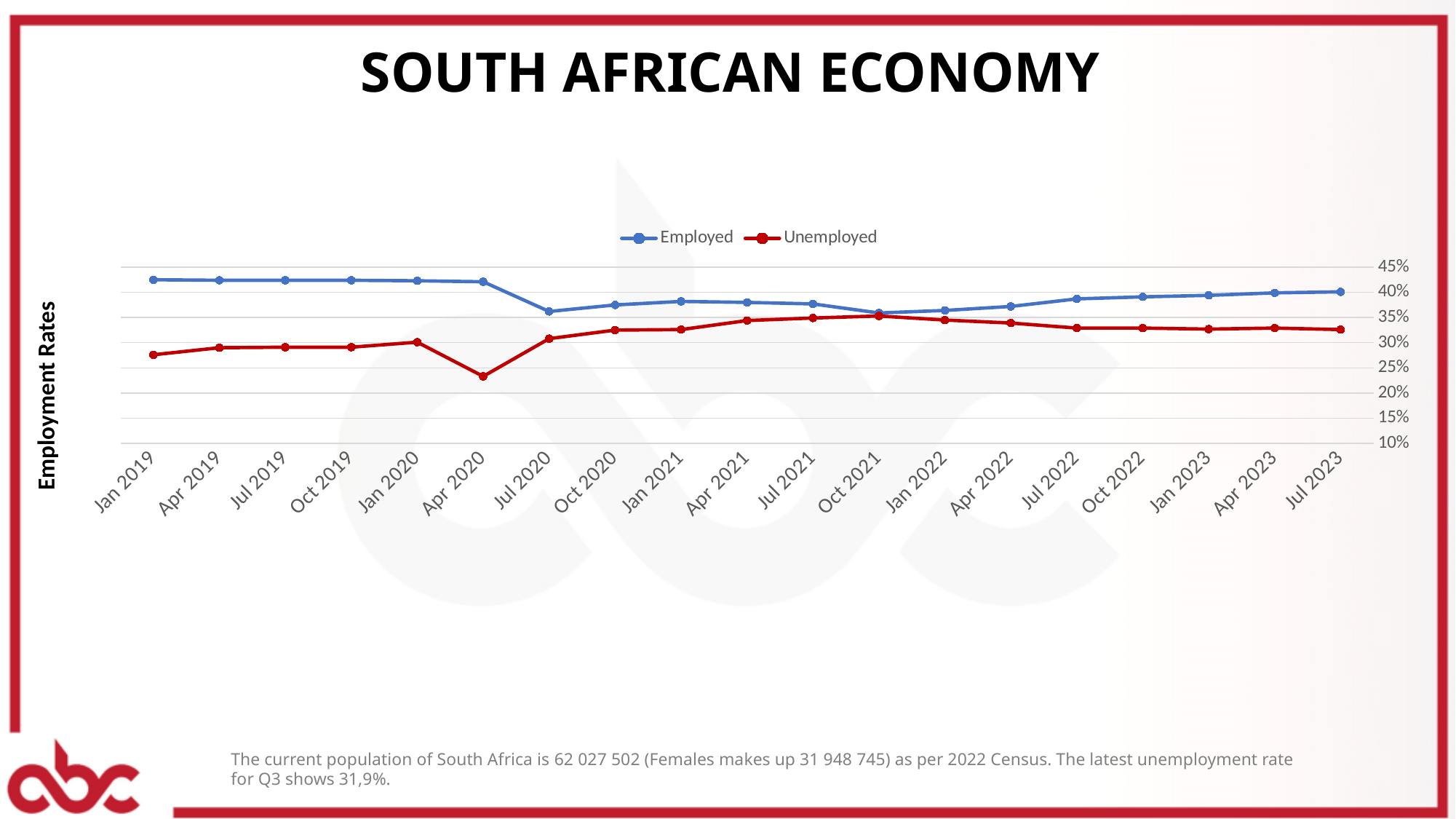
What kind of chart is shown on the slide? line chart How many time points are plotted along the x axis? 19 How many series does the legend list? 2 At which time point is the Unemployed series at its lowest? Apr 2020 Which is larger for the Unemployed series, the value for Apr 2020 or the value for Jul 2020? Jul 2020 Which series has the larger value in Jan 2019, Employed or Unemployed? Employed Is the Employed value for Jul 2020 greater or less than 40%? less Is the Employed value for Jan 2019 greater or less than 40%? greater What is the title of the vertical axis? Employment Rates Is the Unemployed value for Jan 2019 greater or less than 30%? less Does the Employed series rise or fall from Jan 2022 to Jul 2023? rise